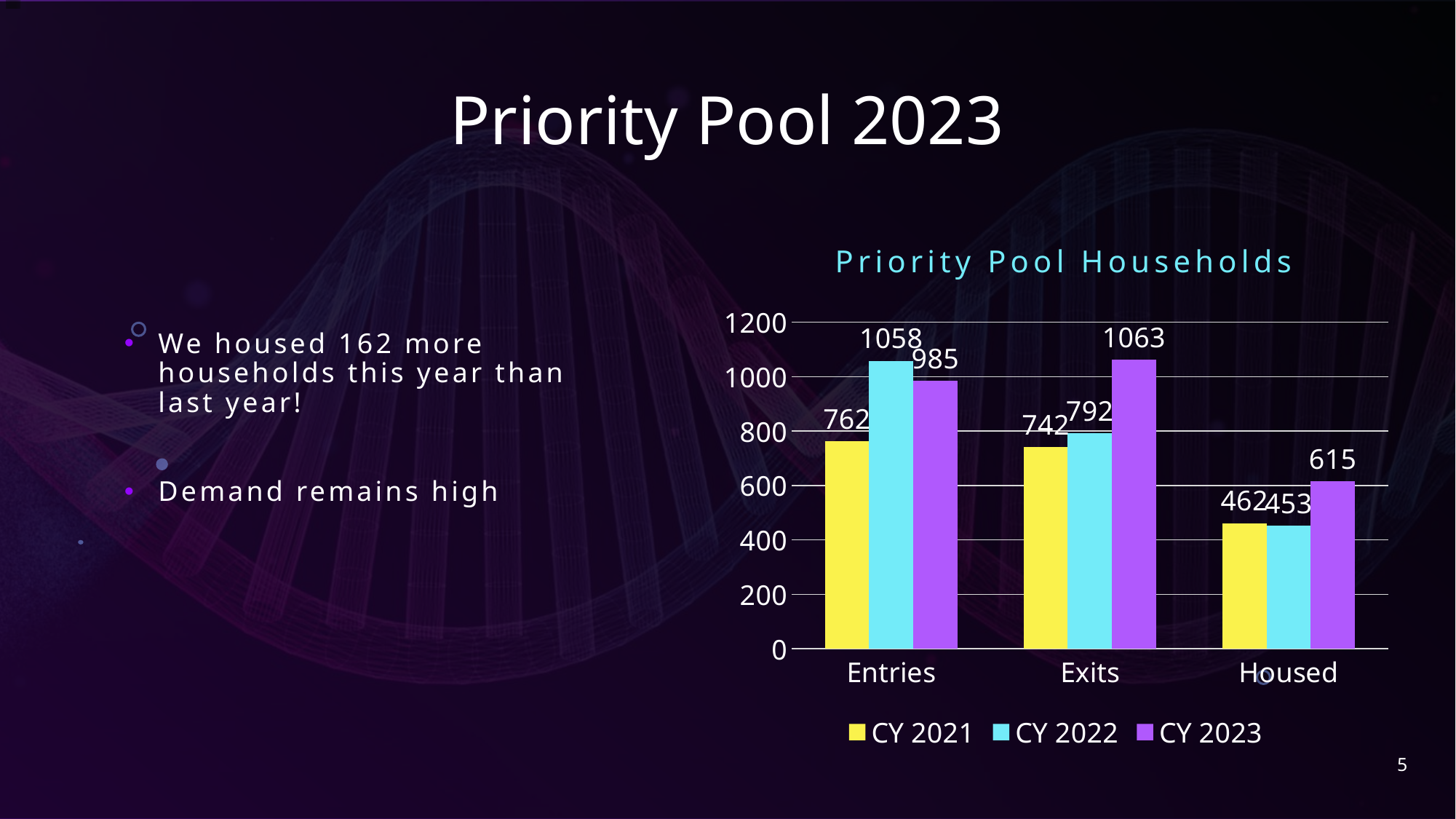
What is the difference between CY 2022 Entries and CY 2023 Entries? 73 Which category has the highest CY 2023 value? Exits What is the value for CY 2023 Housed? 615 What is the value for CY 2021 Exits? 742 Which is larger, CY 2023 Exits or CY 2023 Entries? CY 2023 Exits Which category has the lowest CY 2021 value? Housed How many categories are shown on the x axis? 3 How many series does the legend list? 3 What is the title of the chart? Priority Pool Households What is the value for CY 2022 Entries? 1058 What is the difference between CY 2023 Housed and CY 2022 Housed? 162 What kind of chart is shown? Bar chart